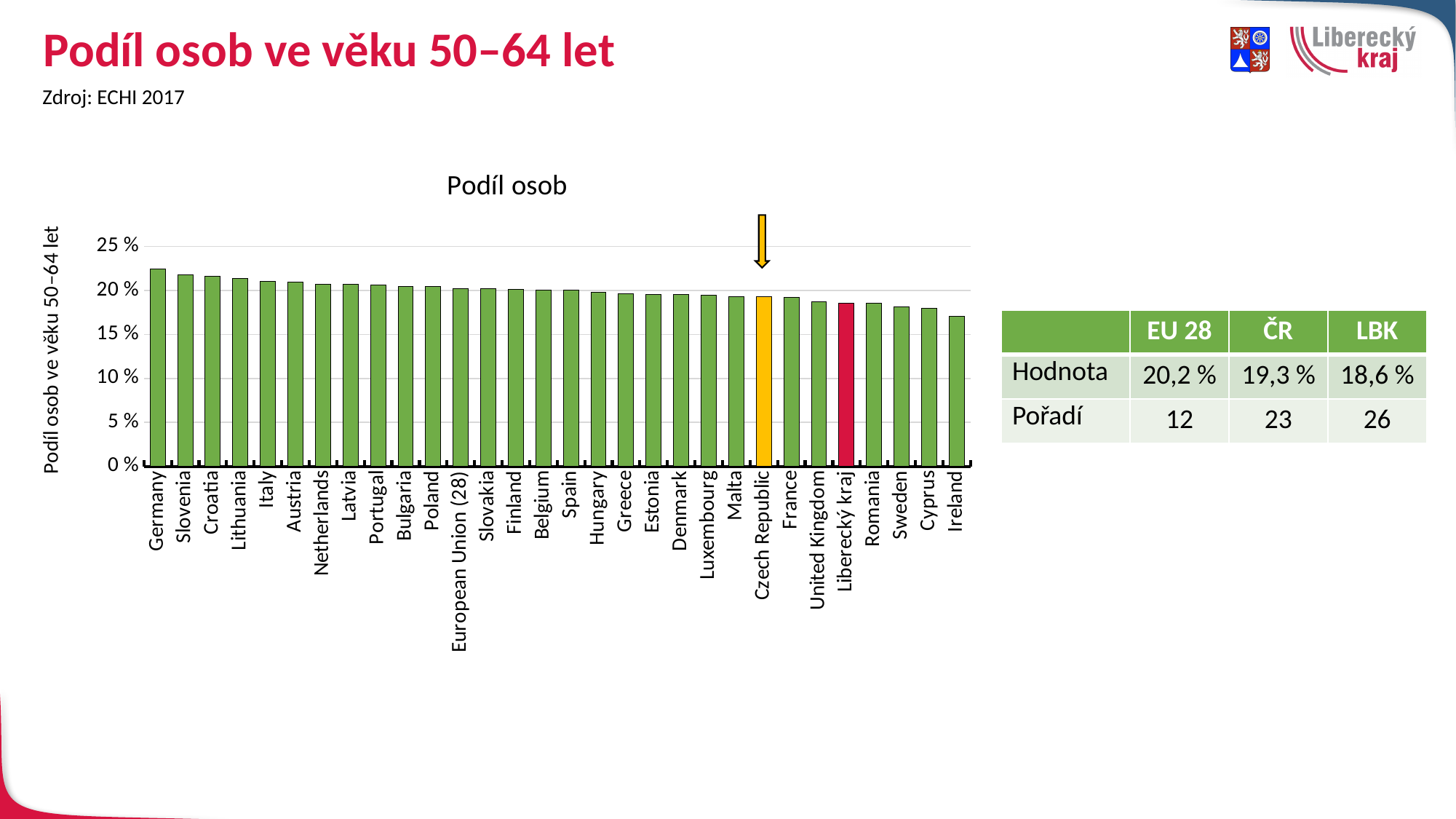
What is the value for European Union (28) according to the slide? 20,2 % Do the values rise or fall from left to right along the x axis? fall What is the value for Liberecký kraj according to the slide? 18,6 % Which category has the highest value in the chart? Germany What is the difference between the values for European Union (28) and Liberecký kraj? 1,6 % What kind of chart is shown on the slide? bar chart Which is larger, the value for Czech Republic or the value for Liberecký kraj? Czech Republic How many categories (bars) does the chart show? 30 Which category has the lowest value in the chart? Ireland What is the value for Czech Republic according to the slide? 19,3 % What is the title of the chart? Podíl osob Is the value for Germany greater or less than 20 %? greater